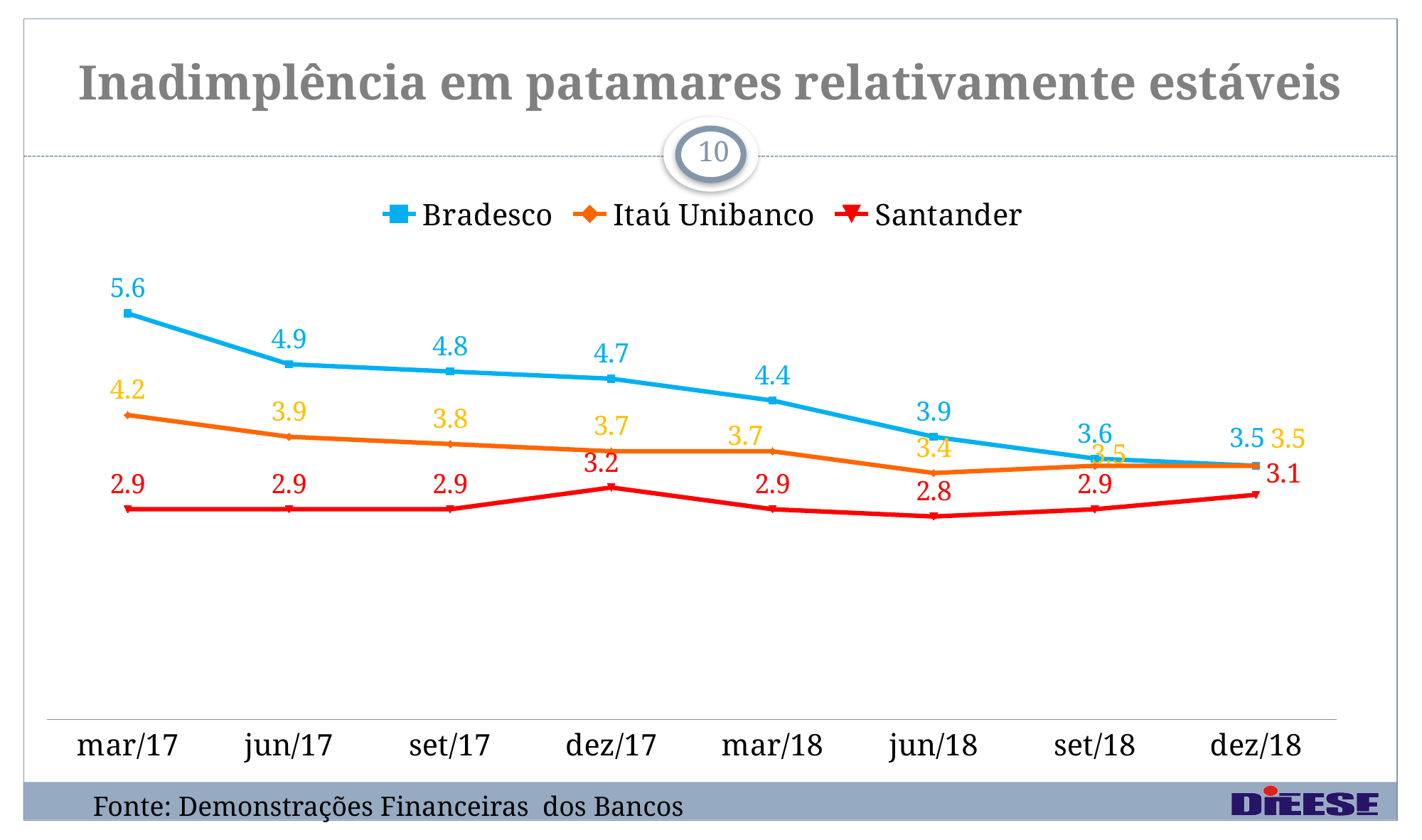
Which is larger in mar/18, the Bradesco value or the Itaú Unibanco value? Bradesco What is the value for Santander in dez/17? 3.2 What is the title of the chart? Inadimplência em patamares relativamente estáveis What is the value for Itaú Unibanco in jun/18? 3.4 In which period is the Santander value lowest? jun/18 In which period is the Bradesco value highest? mar/17 How many time points are shown on the x axis? 8 What is the difference between the Bradesco value in mar/17 and in dez/18? 2.1 Does the Bradesco series rise or fall from mar/17 to dez/18? fall What type of chart is shown on the slide? line chart How many series does the legend list? 3 What is the value for Bradesco in mar/17? 5.6